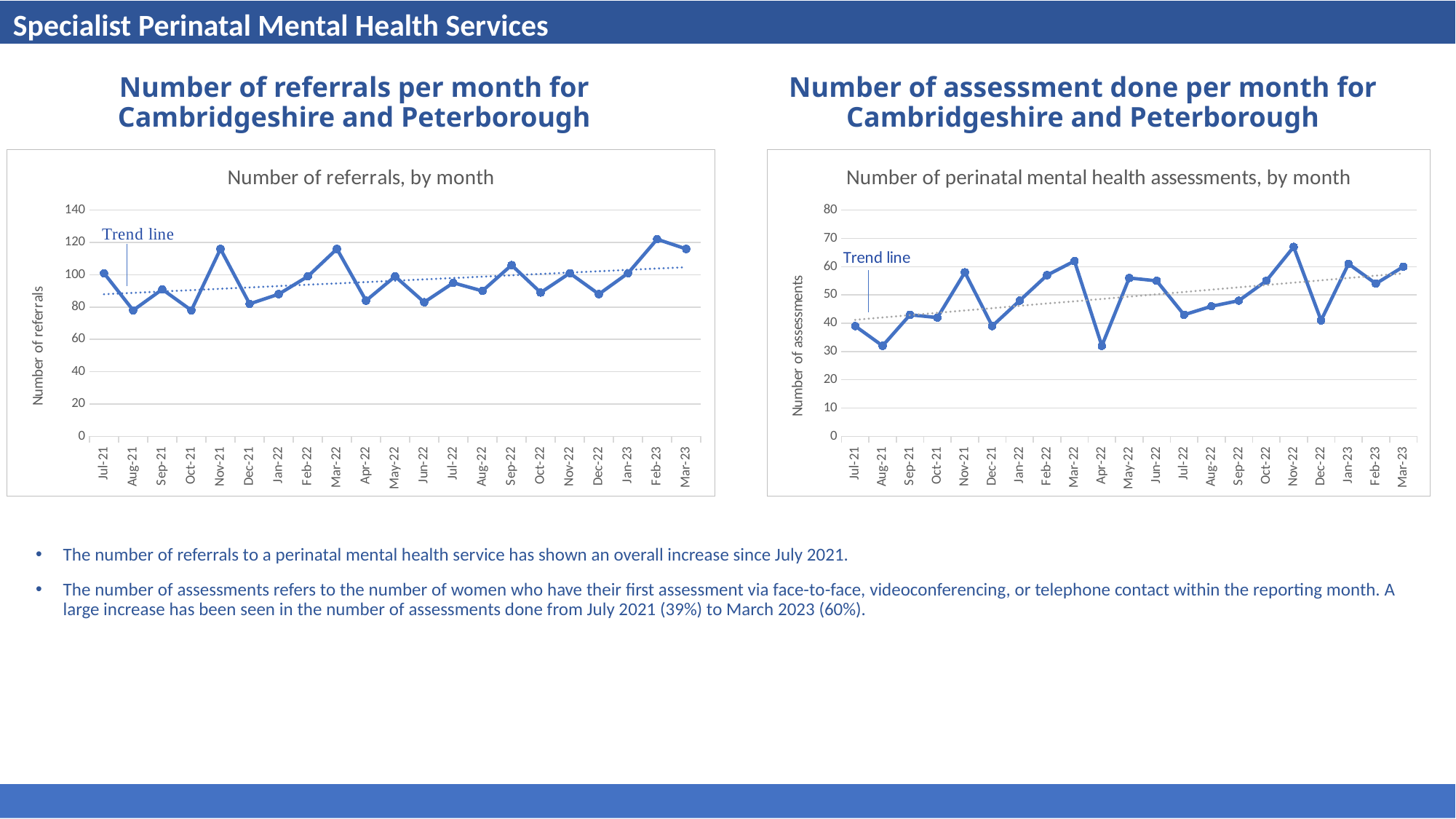
In the 'Number of perinatal mental health assessments, by month' chart on the right, is the value for Nov-22 greater or less than 60? greater What is the y-axis title of the 'Number of referrals, by month' chart on the left? Number of referrals According to the dotted trend line in the 'Number of referrals, by month' chart on the left, do referrals rise or fall over the period? rise How many months are plotted in the 'Number of referrals, by month' chart on the left? 21 In the 'Number of referrals, by month' chart on the left, is the value for Nov-21 greater or less than 100? greater In the 'Number of referrals, by month' chart on the left, is the value for Dec-21 greater or less than 100? less In the 'Number of perinatal mental health assessments, by month' chart on the right, which month has more assessments, Nov-21 or Dec-21? Nov-21 In the 'Number of referrals, by month' chart on the left, which month has more referrals, Nov-21 or Dec-21? Nov-21 What kind of chart is the 'Number of referrals, by month' chart on the left? line chart In the 'Number of referrals, by month' chart on the left, which month has the highest number of referrals? Feb-23 In the 'Number of perinatal mental health assessments, by month' chart on the right, which month has the highest number of assessments? Nov-22